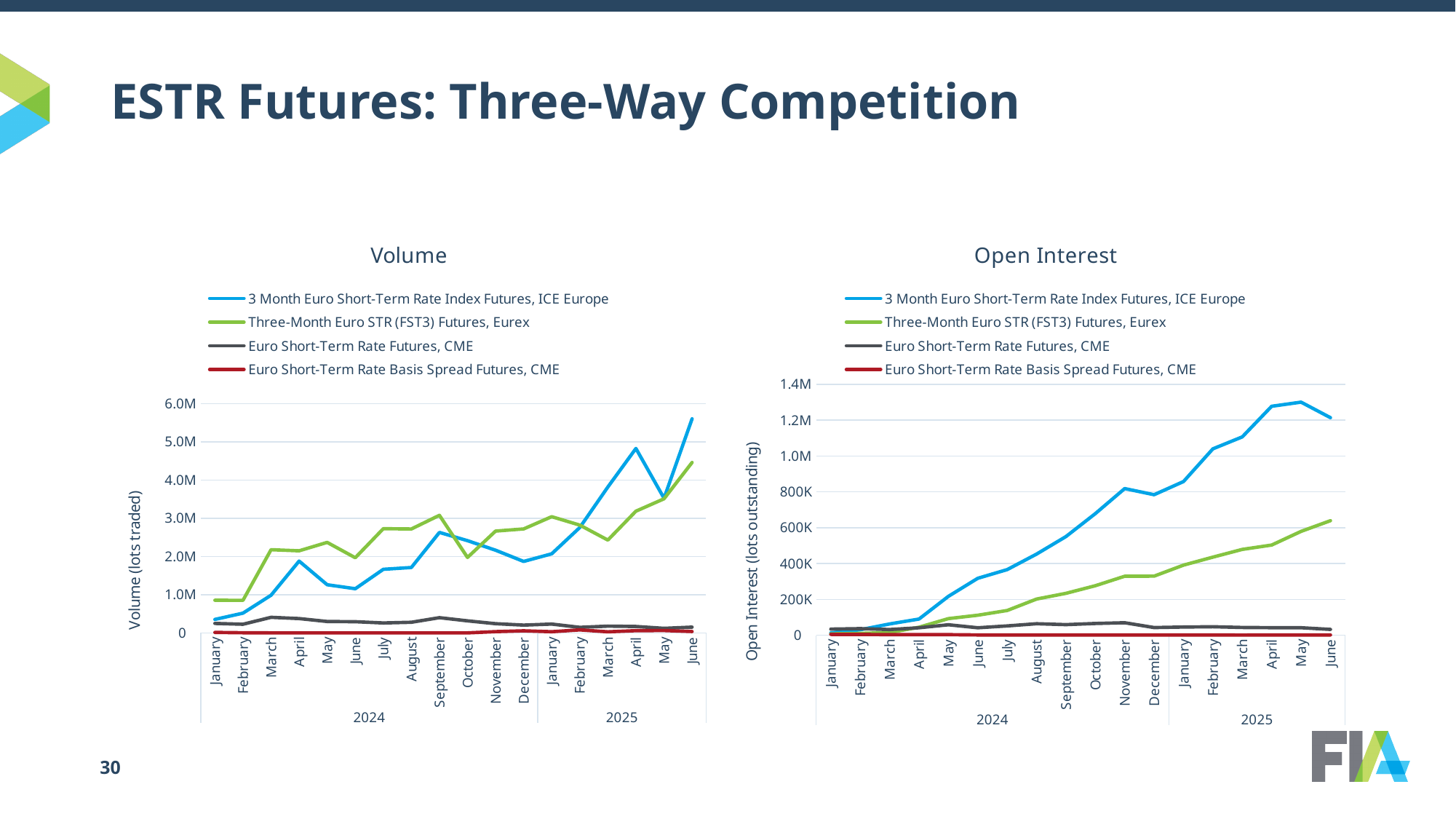
In the Volume chart, which series has the higher value in March 2024: ICE Europe or Eurex? Three-Month Euro STR (FST3) Futures, Eurex In the Volume chart, is the June 2025 value for 3 Month Euro Short-Term Rate Index Futures, ICE Europe greater or less than 5.0M? greater What kind of chart is the Volume chart? Line chart In the Open Interest chart, is the May 2025 value for 3 Month Euro Short-Term Rate Index Futures, ICE Europe greater or less than 1.2M? greater In the Open Interest chart, is the December 2024 value for Three-Month Euro STR (FST3) Futures, Eurex greater or less than 200K? greater In the Open Interest chart, does the ICE Europe series generally rise or fall from January 2024 to May 2025? Rise What is the y-axis label of the Open Interest chart? Open Interest (lots outstanding) How many months are plotted along the x axis of the Volume chart? 18 In the Open Interest chart, which series has the higher value in June 2025: ICE Europe or Eurex? 3 Month Euro Short-Term Rate Index Futures, ICE Europe How many series does the legend of the Open Interest chart list? 4